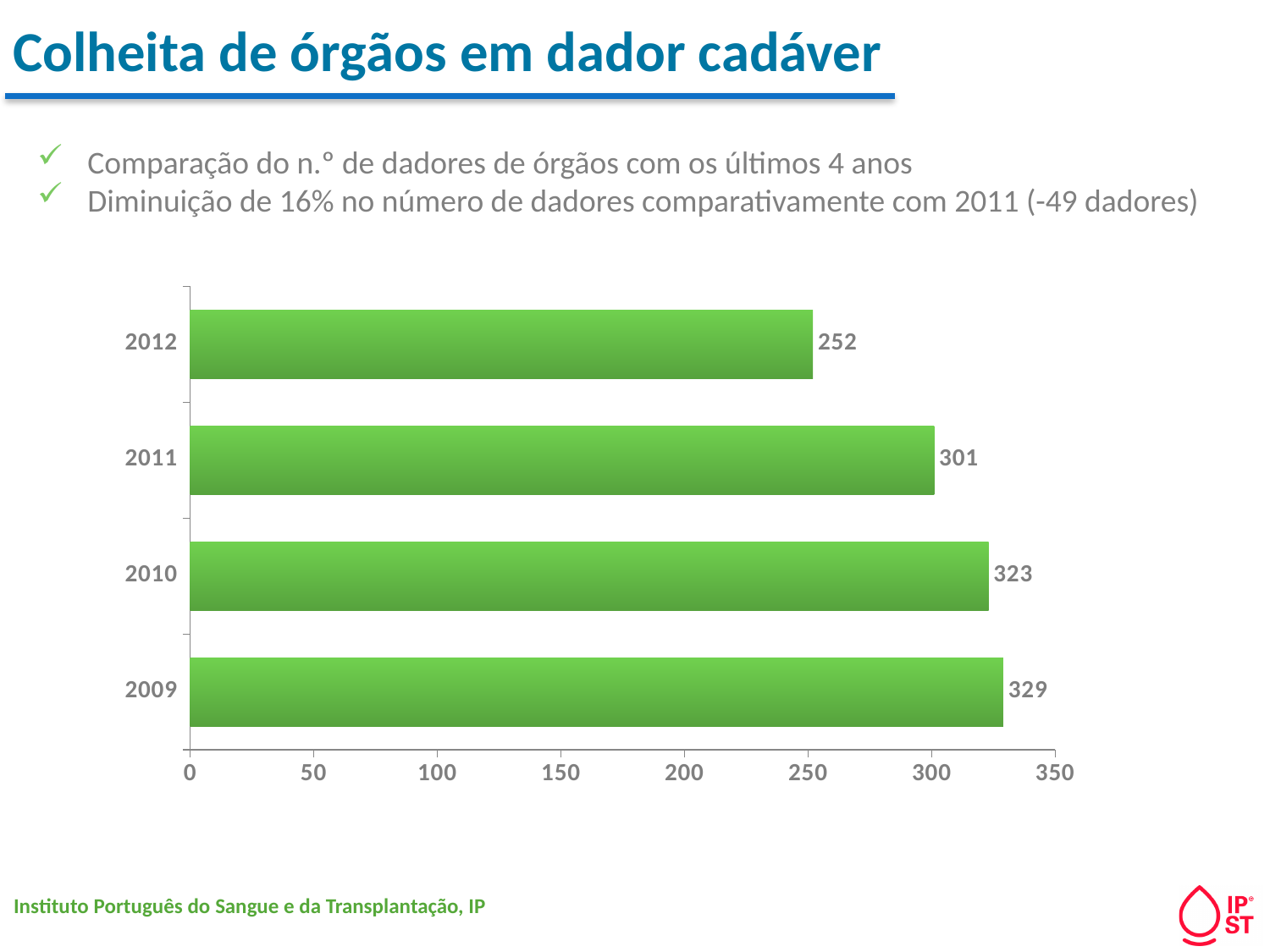
What is the value for 2012? 252 Which year has the highest value? 2009 Which is larger, the value for 2010 or the value for 2011? 2010 What is the value for 2009? 329 What is the title of the slide? Colheita de órgãos em dador cadáver Which year has the lowest value? 2012 What is the value for 2010? 323 Is the value for 2012 greater or less than 300? less What kind of chart is shown on the slide? bar chart What is the difference between the values for 2011 and 2012? 49 How many years are shown in the chart? 4 What is the value for 2011? 301